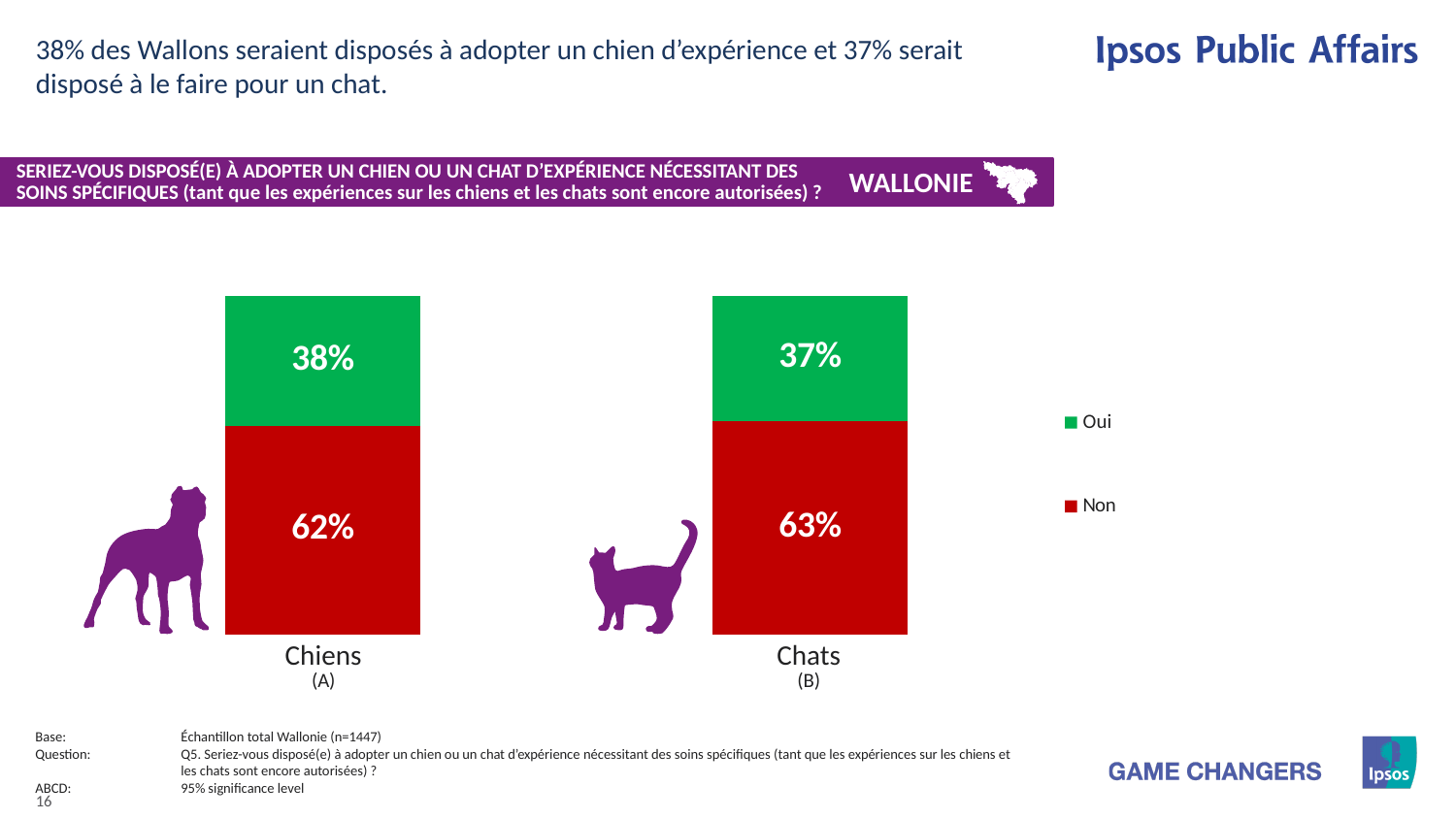
Which colour represents "Non" in the legend? Red What percentage of respondents answered "Oui" for Chiens? 38% What is the total of the stacked bar for Chiens? 100% How many categories are shown on the x axis? 2 What kind of chart is shown on the slide? Stacked bar chart What is the "Oui" value for Chats? 37% What is the difference between the "Non" value for Chats and the "Non" value for Chiens? 1% Which category has the higher "Non" share, Chiens or Chats? Chats How many series does the legend list? 2 What percentage of respondents answered "Non" for Chats? 63% What is the "Non" value for Chiens? 62% Which category has the higher "Oui" share, Chiens or Chats? Chiens